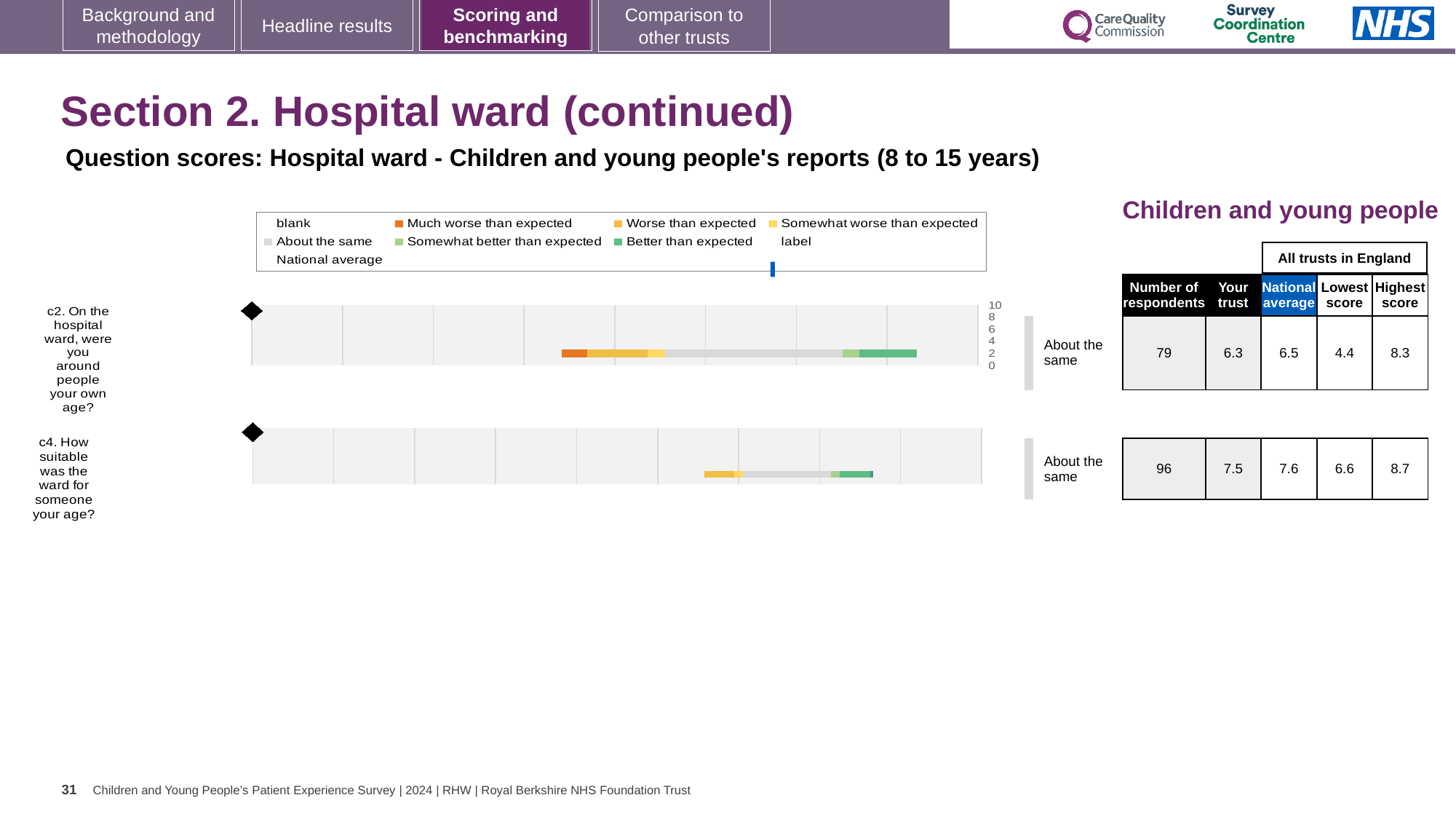
By how much does the national average exceed the 'Your trust' score for c4? 0.1 What benchmark category is shown next to the c2 bar? About the same Which question has the higher 'Your trust' score, c2 or c4? c4 What is the lowest score across all trusts in England for c4? 6.6 What is the national average score for c4 (How suitable was the ward for someone your age?)? 7.6 What is the 'Your trust' score for c2 (On the hospital ward, were you around people your own age?)? 6.3 What is the difference between the highest score and the lowest score for c2? 3.9 How many questions (bars) are plotted on the slide? 2 How many respondents answered question c2? 79 Which legend entry is shown in orange? Much worse than expected What is the highest score across all trusts in England for c4? 8.7 What kind of chart is used to show the question scores for c2 and c4? bar chart